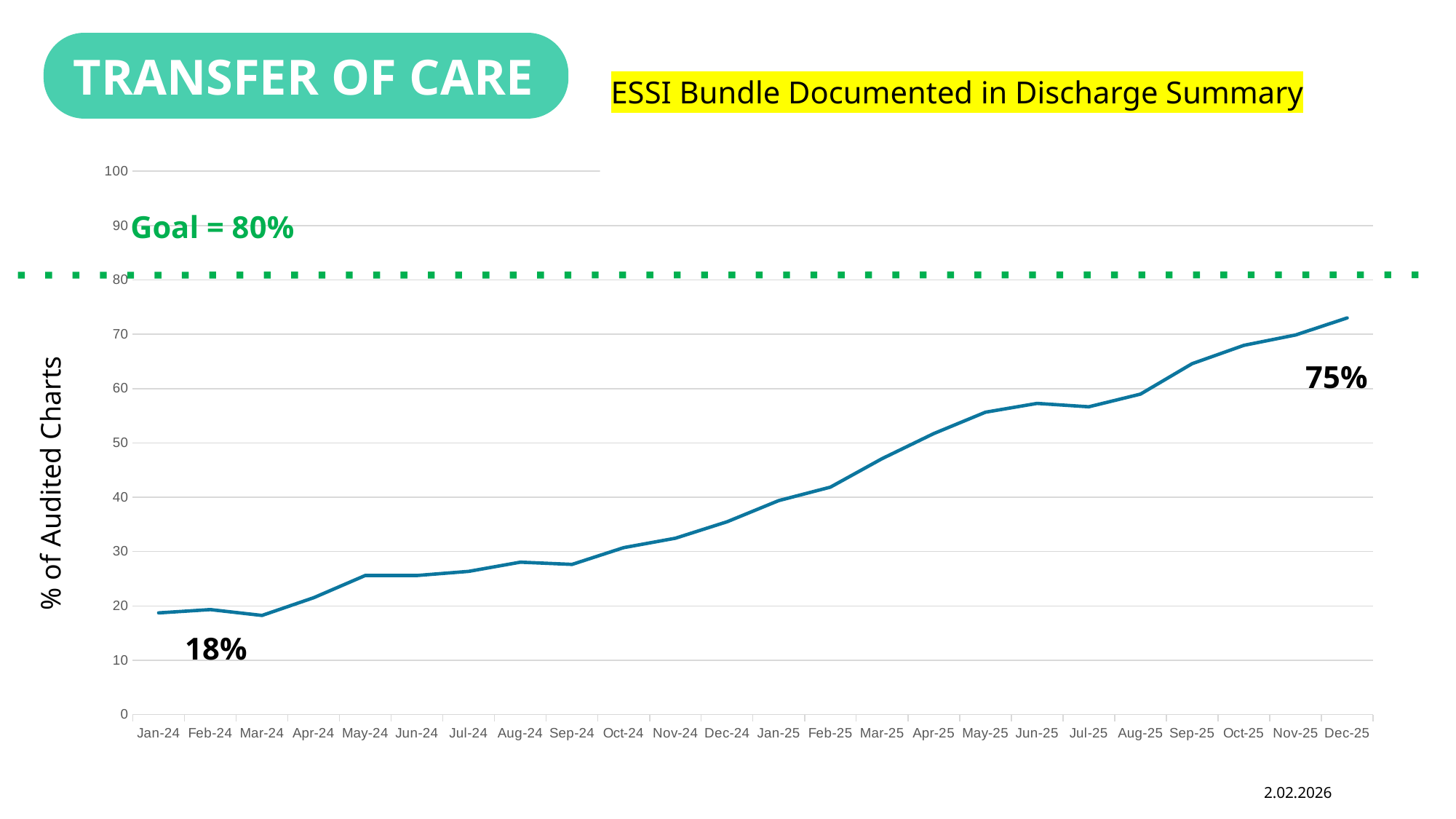
Do the values generally rise or fall from Jan-24 to Dec-25? rise Which is larger, the value for Dec-24 or the value for Jan-25? Jan-25 What is the title of the chart? ESSI Bundle Documented in Discharge Summary How many months are plotted along the x axis? 24 What value is labelled for Jan-24 on the chart? 18% Which month has the highest value on the chart? Dec-25 What is the label on the vertical axis of the chart? % of Audited Charts Is the value for Dec-25 greater or less than 70? greater What kind of chart is shown on the slide? line chart What goal value is marked by the dashed line on the chart? 80% Is the value for May-24 greater or less than 30? less Is the value for Sep-25 greater or less than 60? greater